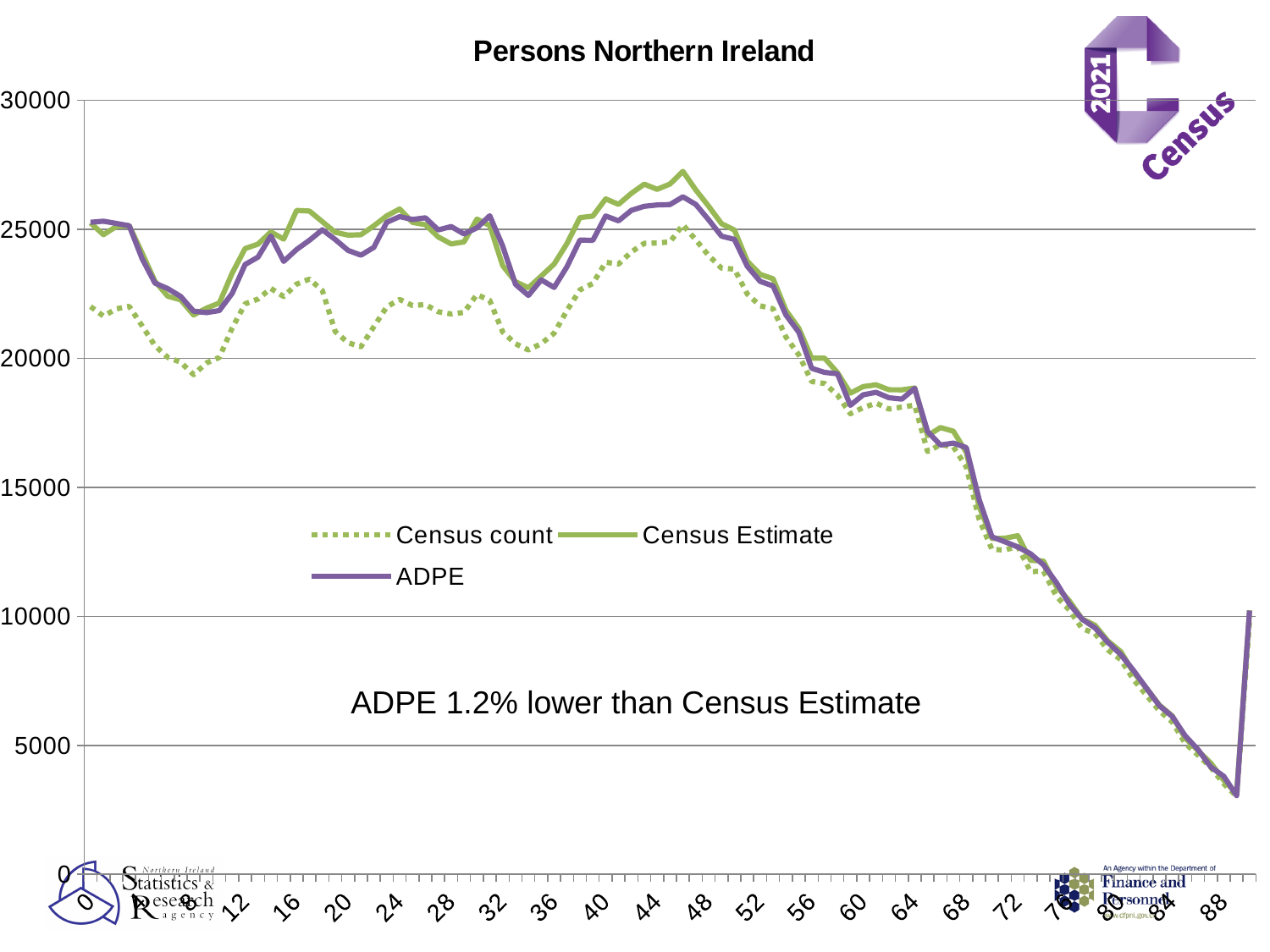
Do the ADPE values rise or fall along the x axis from age 48 to age 88? fall How many series does the legend list? 3 Is the Census count value at age 0 greater or less than 25000? less Is the Census Estimate value at age 60 greater or less than 20000? less At age 8, which is larger, the Census Estimate or the Census count? Census Estimate What is the title of the chart? Persons Northern Ireland Is the ADPE value at age 88 greater or less than 5000? less What are the three series named in the legend? Census count, Census Estimate, ADPE At age 44, which is larger, the Census Estimate or ADPE? Census Estimate What kind of chart is shown on the slide? line chart